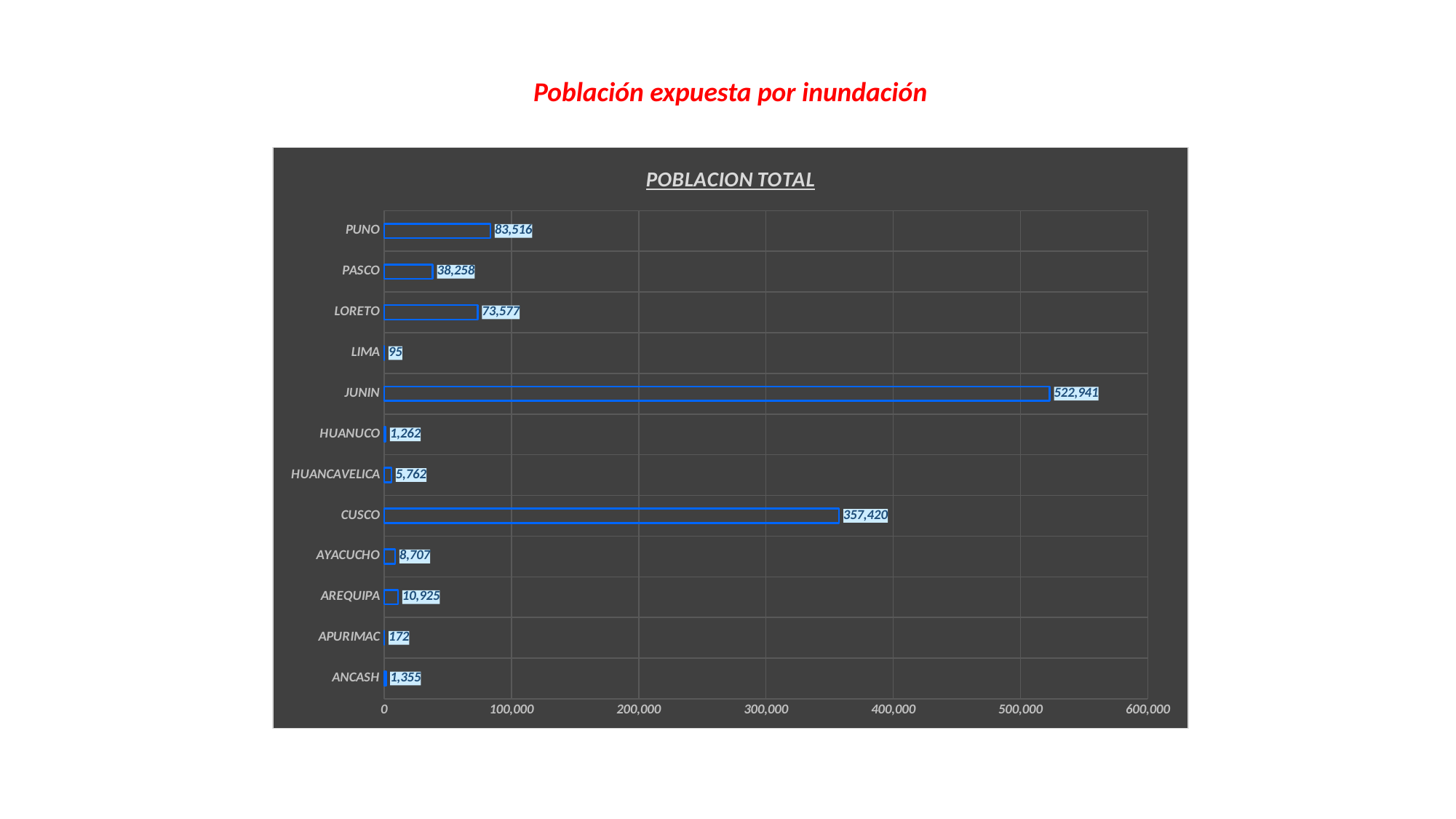
How many categories are shown in the chart? 12 Is the value for CUSCO greater or less than 300,000? greater What is the value for LIMA? 95 What is the value for PUNO? 83,516 What is the title of the chart? POBLACION TOTAL What kind of chart is shown on the slide? bar chart Which is larger, the value for PUNO or the value for LORETO? PUNO Which category has the highest value? JUNIN What is the value for JUNIN? 522,941 Which category has the lowest value? LIMA What is the value for CUSCO? 357,420 What is the difference between the values for JUNIN and CUSCO? 165,521